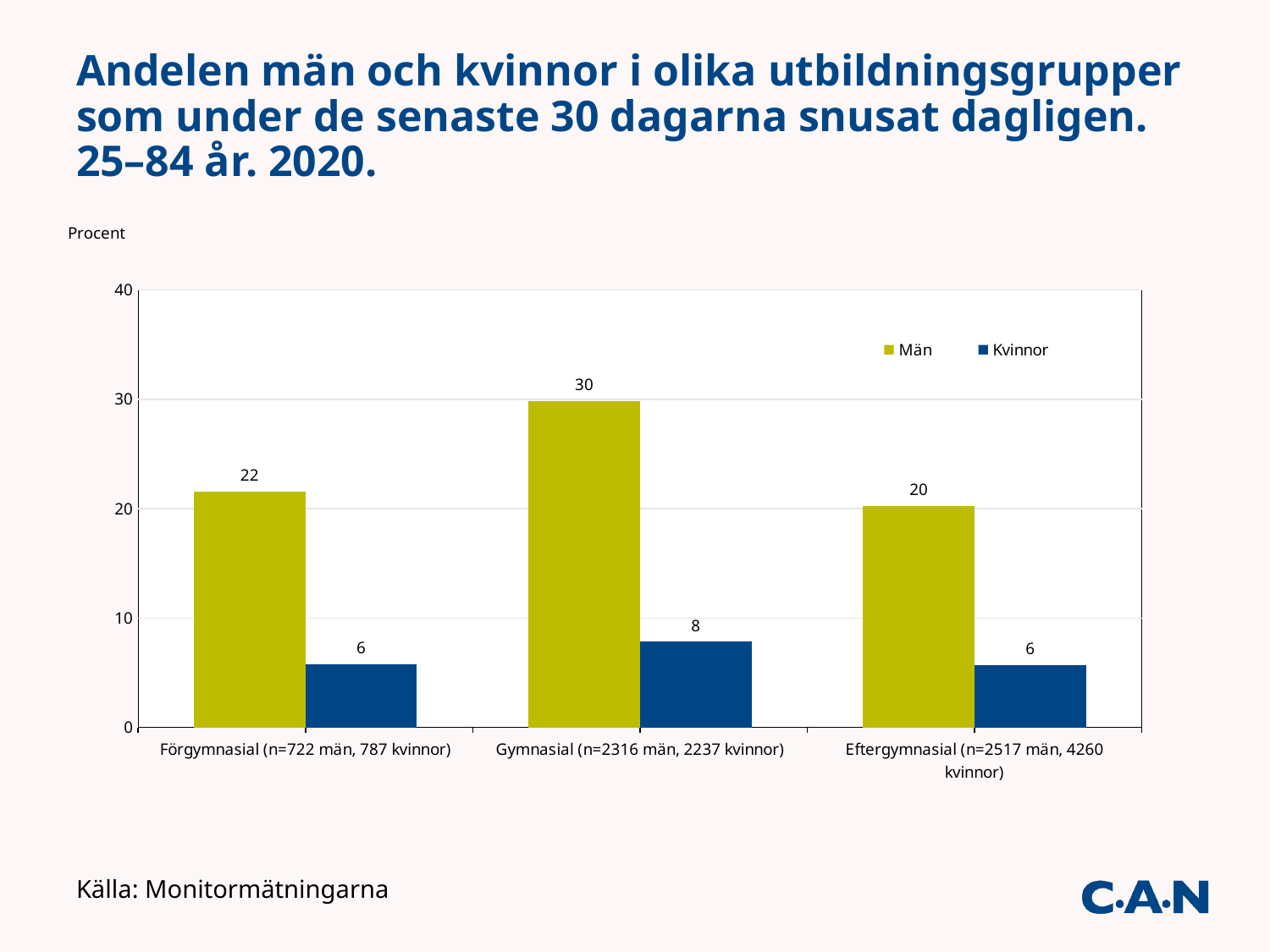
What is the value for Män in the Eftergymnasial group? 20 How many series does the legend list? 2 What is the value for Kvinnor in the Förgymnasial group? 6 Which is larger, the Män value for Förgymnasial or the Män value for Eftergymnasial? Förgymnasial Which education group has the lowest value for Män? Eftergymnasial Which education group has the highest value for Kvinnor? Gymnasial What is the difference between the Män and Kvinnor values in the Gymnasial group? 22 What kind of chart is shown on the slide? Bar chart What is the value for Kvinnor in the Gymnasial group? 8 What is the value for Män in the Gymnasial group? 30 Which education group has the highest value for Män? Gymnasial How many education groups are shown on the x axis? 3